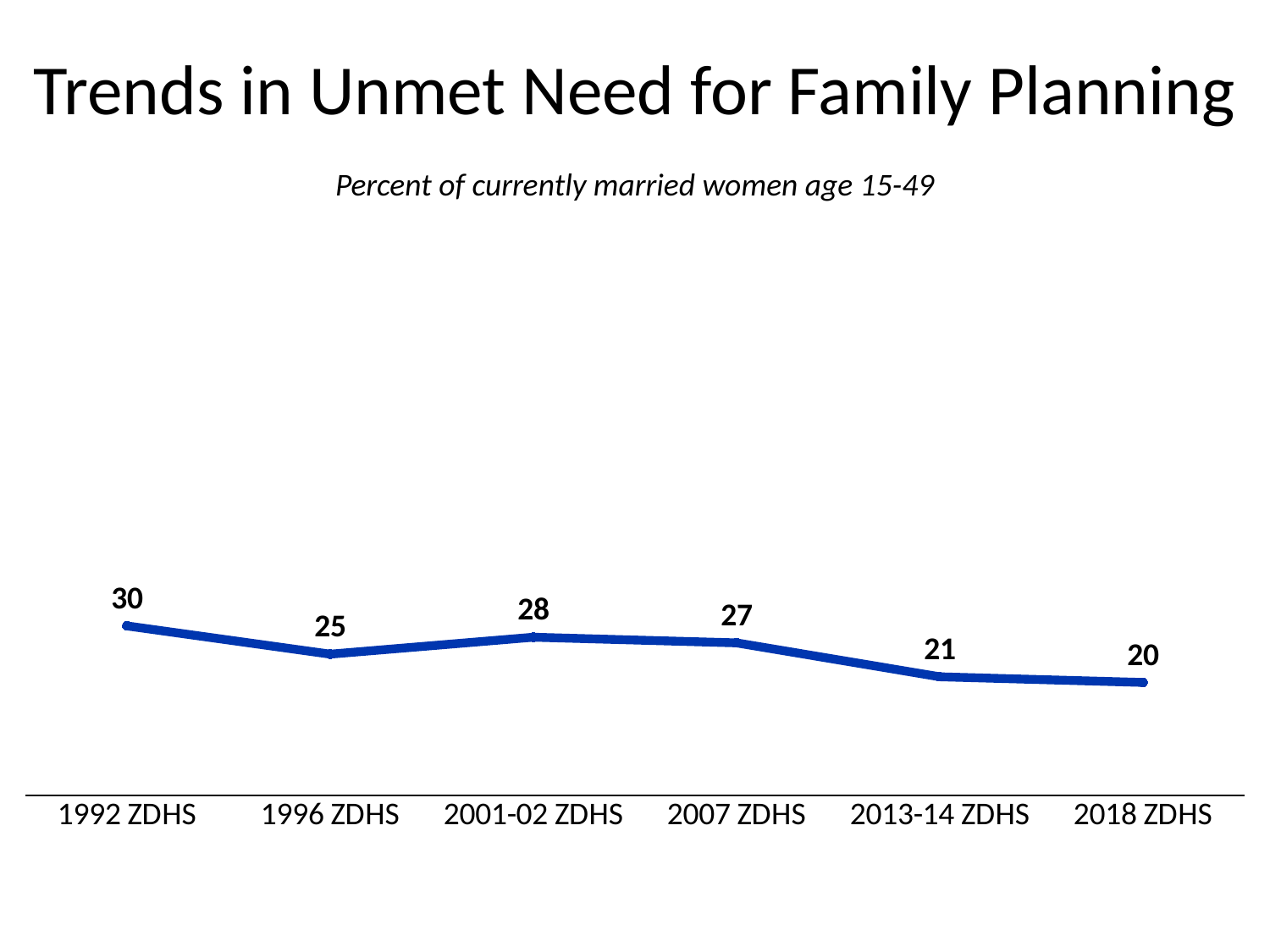
What is the difference between the 1992 ZDHS value and the 2018 ZDHS value? 10 What kind of chart is shown on the slide? Line chart What is the value shown for the 2007 ZDHS? 27 Which survey has the highest unmet need for family planning? 1992 ZDHS How many surveys are plotted on the chart? 6 What is the value shown for the 2018 ZDHS? 20 Overall, does the unmet need for family planning rise or fall from the 1992 ZDHS to the 2018 ZDHS? Fall What is the value shown for the 2013-14 ZDHS? 21 What is the unmet need for family planning in the 1992 ZDHS? 30 What is the difference between the 2001-02 ZDHS value and the 1996 ZDHS value? 3 Which is larger, the value for the 1996 ZDHS or the value for the 2001-02 ZDHS? 2001-02 ZDHS Which survey has the lowest unmet need for family planning? 2018 ZDHS